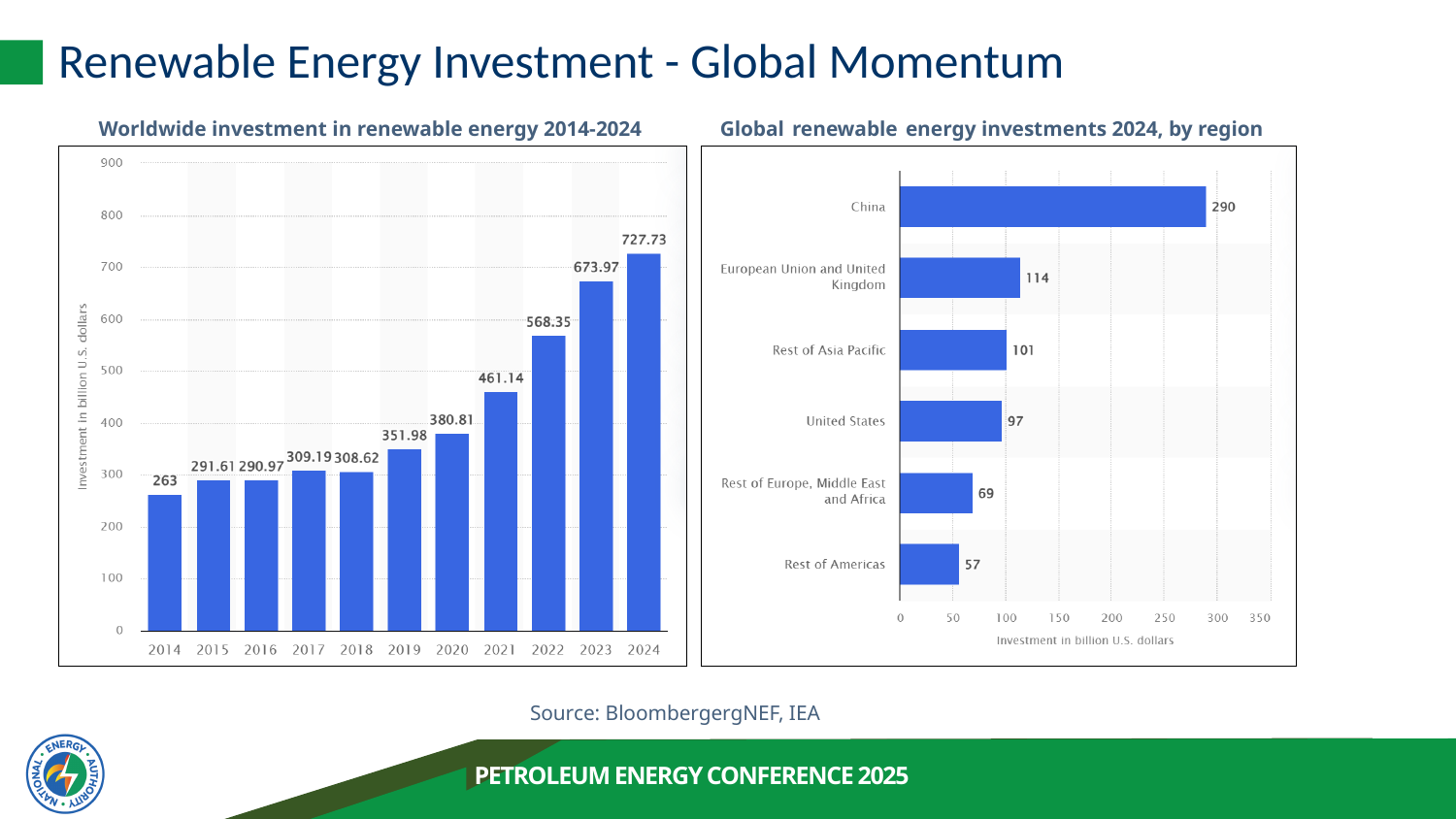
In the 'Worldwide investment in renewable energy 2014-2024' chart, what is the difference between the 2024 and 2023 values? 53.76 In the 'Global renewable energy investments 2024, by region' chart, what is the difference between China and the European Union and United Kingdom? 176 In the 'Global renewable energy investments 2024, by region' chart, what is the value for the United States? 97 In the 'Worldwide investment in renewable energy 2014-2024' chart, how many years are shown on the x axis? 11 What kind of chart is the 'Global renewable energy investments 2024, by region' chart? bar chart In the 'Worldwide investment in renewable energy 2014-2024' chart, what is the value for 2024? 727.73 In the 'Global renewable energy investments 2024, by region' chart, which is larger: Rest of Asia Pacific or Rest of Europe, Middle East and Africa? Rest of Asia Pacific In the 'Global renewable energy investments 2024, by region' chart, what is the value for China? 290 In the 'Worldwide investment in renewable energy 2014-2024' chart, what is the value for 2014? 263 In the 'Worldwide investment in renewable energy 2014-2024' chart, do the values generally rise or fall from 2019 to 2024? rise In the 'Global renewable energy investments 2024, by region' chart, which region has the lowest investment? Rest of Americas In the 'Worldwide investment in renewable energy 2014-2024' chart, which year has the lowest investment? 2014